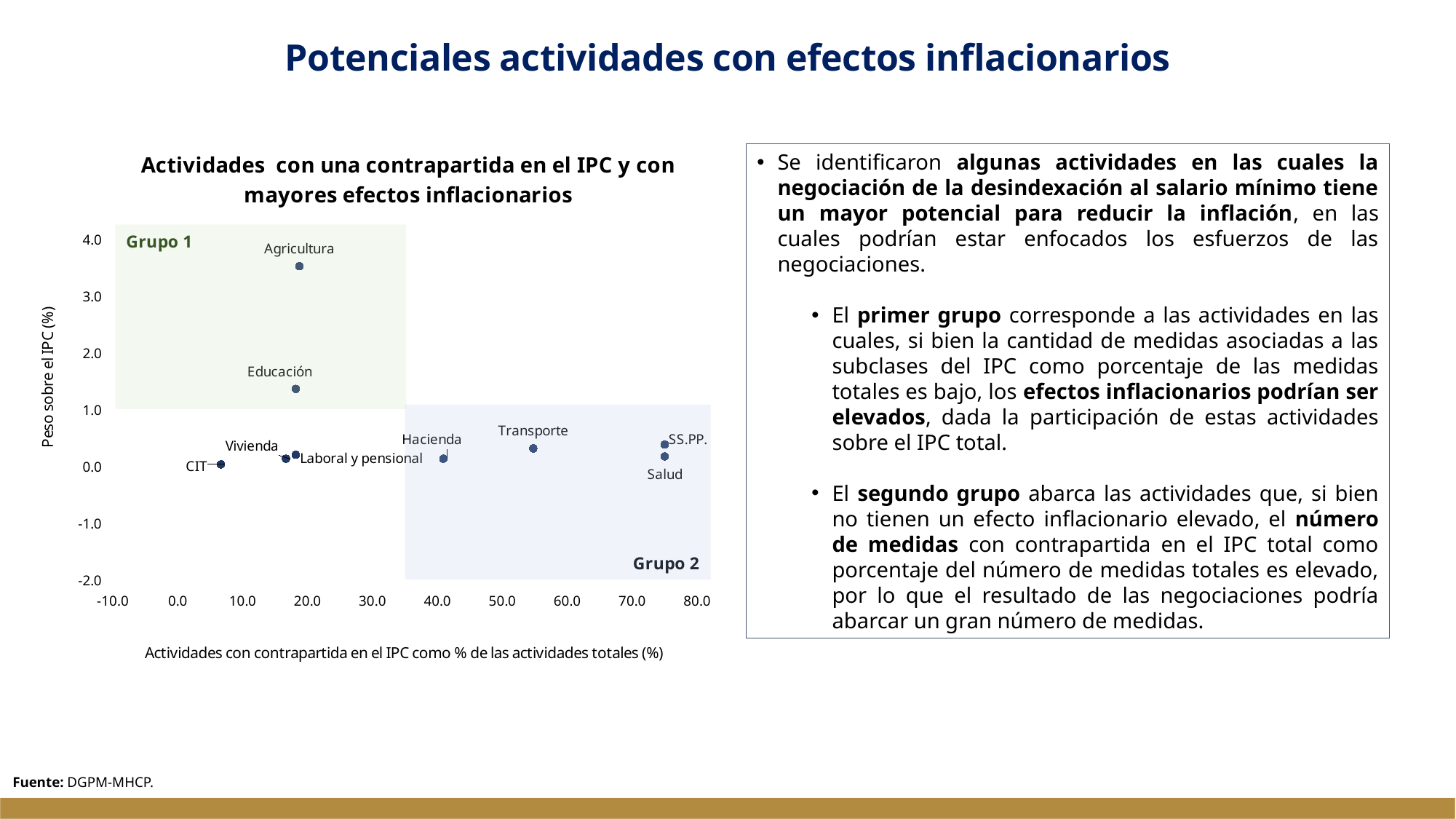
Which activity has the lowest value on the horizontal axis (Actividades con contrapartida en el IPC como % de las actividades totales)? CIT Is the horizontal-axis value for Transporte greater or less than 50.0? greater How many activities are plotted as points in the chart? 9 Which activity has the highest value on the vertical axis (Peso sobre el IPC)? Agricultura Is the vertical-axis value (Peso sobre el IPC) for Educación greater or less than 1.0? greater What are the two groups labelled in the shaded regions of the chart? Grupo 1 and Grupo 2 Which has a higher value on the vertical axis (Peso sobre el IPC): Agricultura or Educación? Agricultura What kind of chart is shown on the slide? Scatter chart Is the horizontal-axis value for CIT greater or less than 10.0? less Which has a higher value on the horizontal axis: Transporte or Hacienda? Transporte What is the title of the chart? Actividades con una contrapartida en el IPC y con mayores efectos inflacionarios